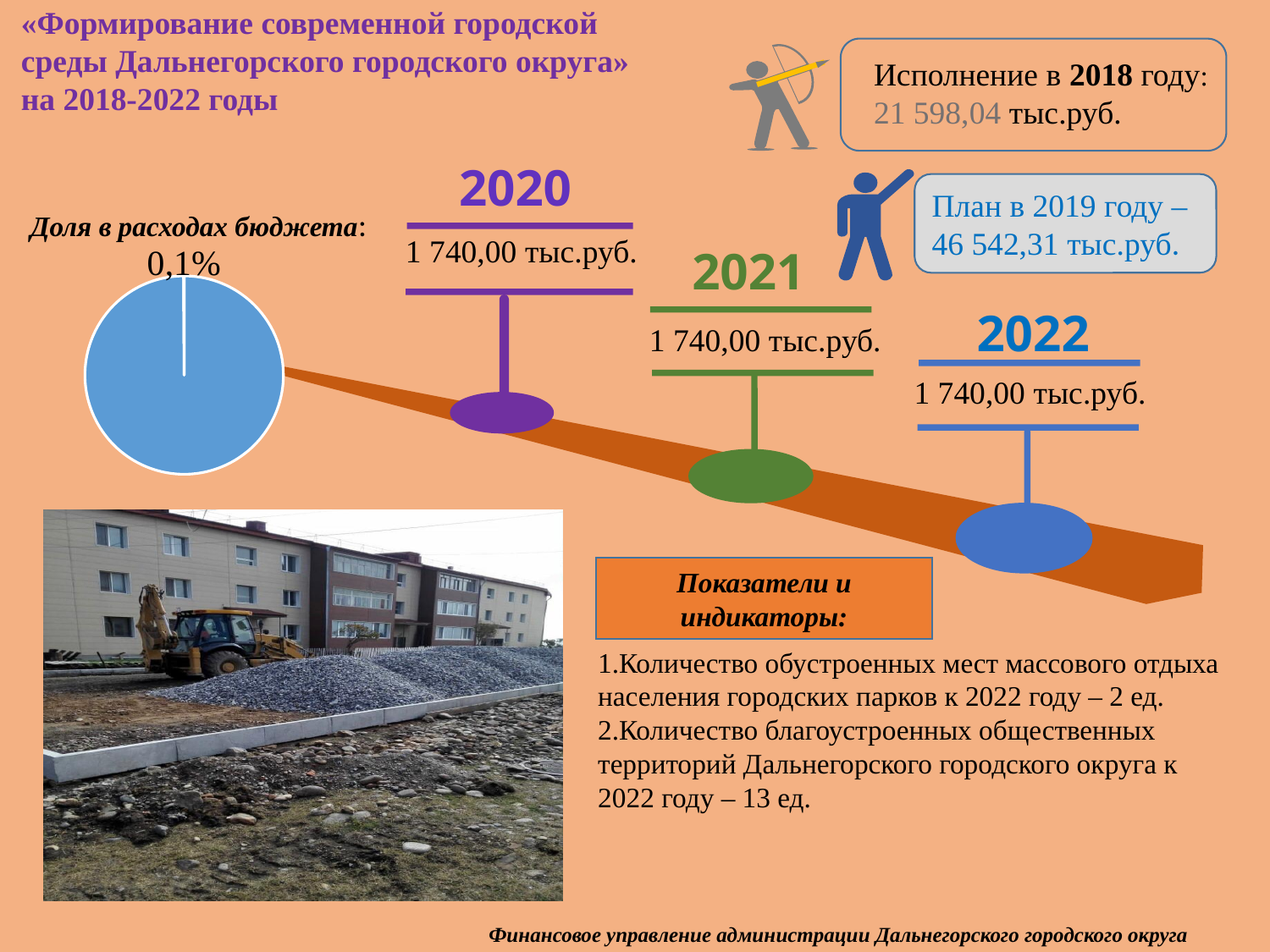
What share is printed as the data label on the pie chart «Доля в расходах бюджета»? 0,1% Is the share shown on the pie chart «Доля в расходах бюджета» greater or less than 1%? less What is the title written above the pie chart on the left of the slide? Доля в расходах бюджета What kind of chart is shown under the heading «Доля в расходах бюджета»? pie chart What colour is the large slice of the pie chart «Доля в расходах бюджета»? blue